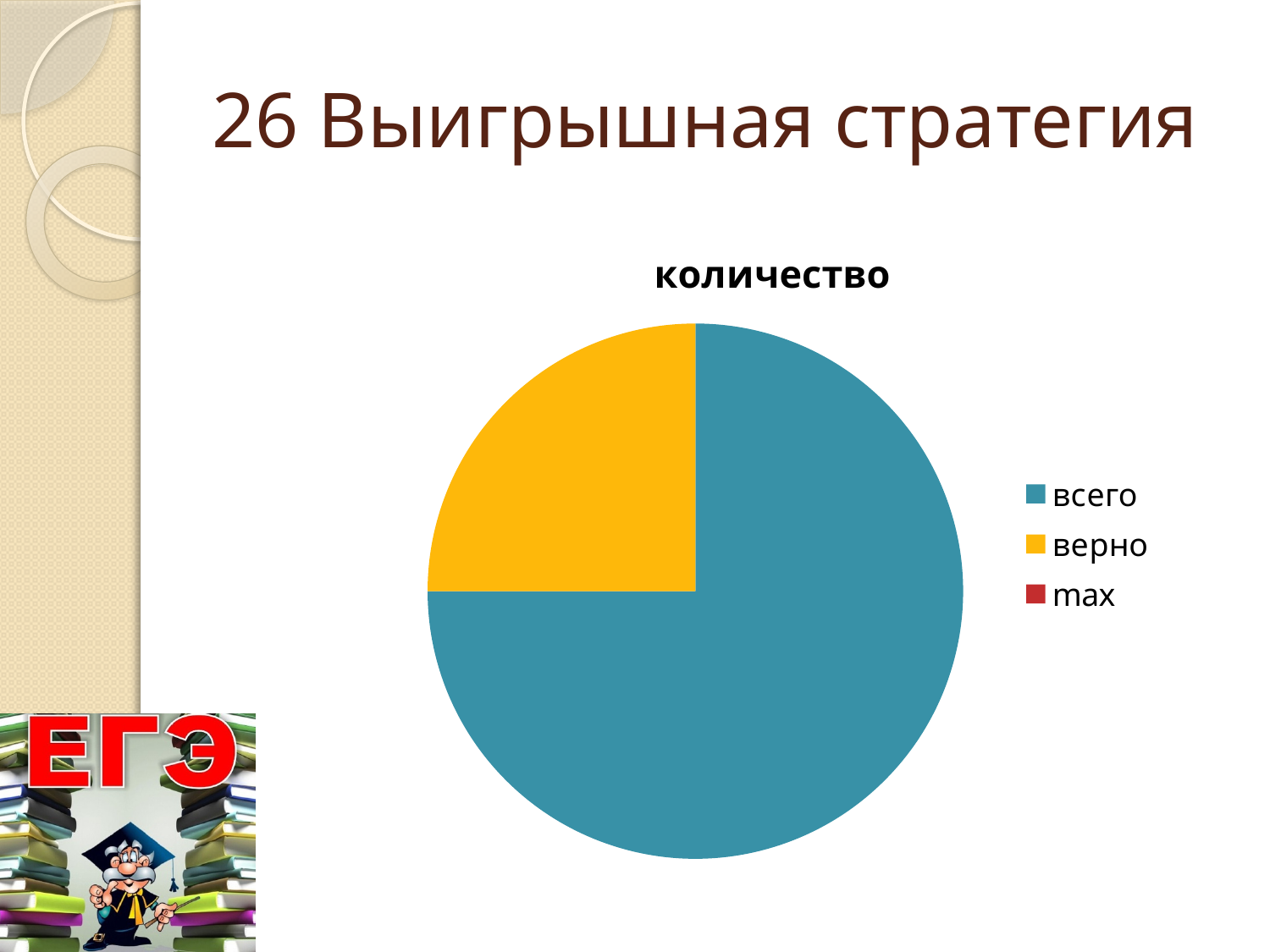
How many entries does the chart legend list? 3 What colour is the всего slice? blue What kind of chart is shown on the slide? pie chart How many slices are visible in the pie? 2 Which category has the largest slice of the pie? всего Which slice is larger, всего or верно? всего Which legend entry has no visible slice in the pie? max What is the title of the chart? количество